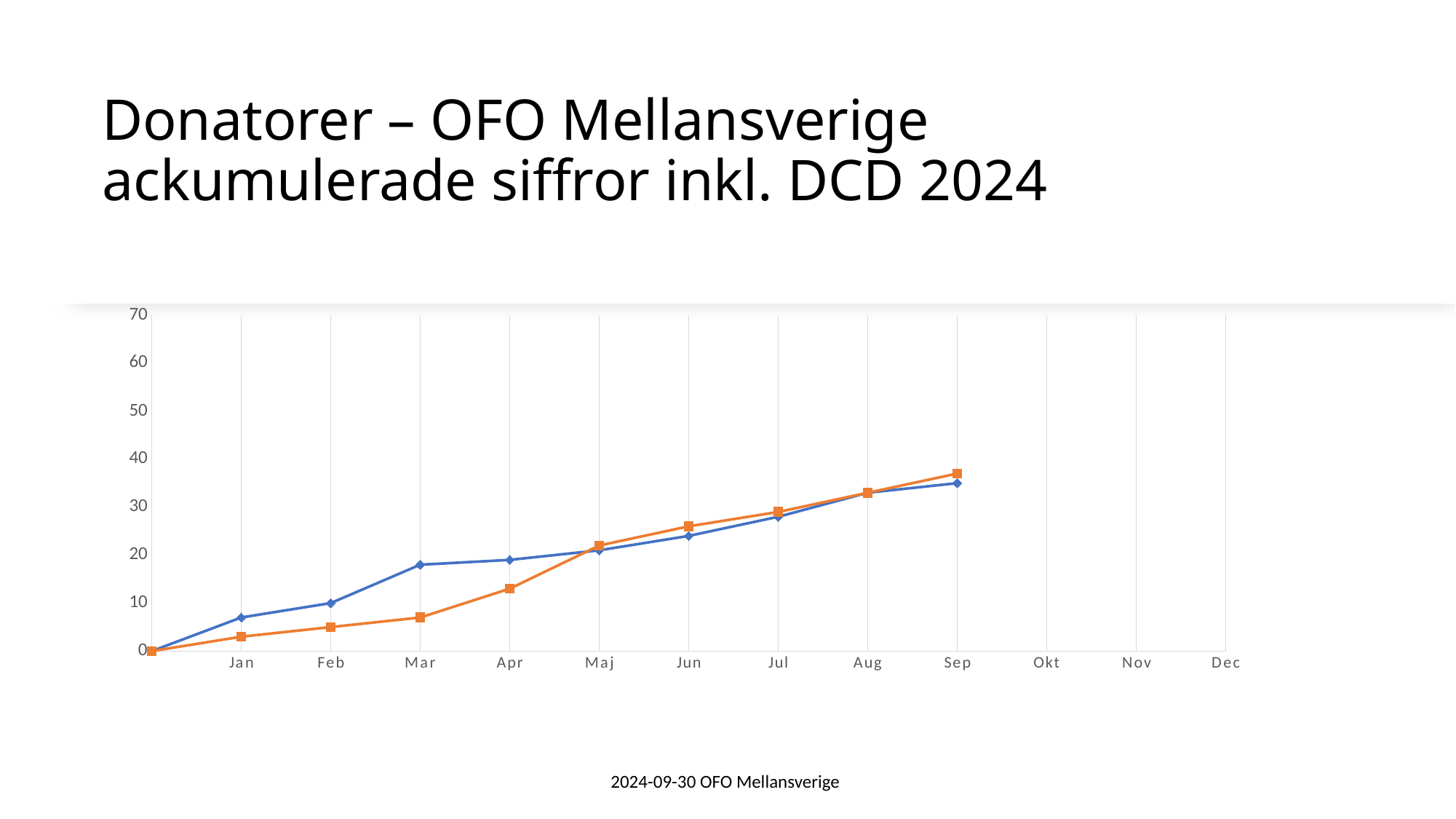
Is the value of the orange line in Jun greater or less than 20? greater Is the value of the blue line in Mar greater or less than 10? greater In Mar, which line has the higher value, the blue line or the orange line? the blue line What is the highest value shown on the y axis? 70 Is the value of the orange line in Jan greater or less than 10? less Do the values of the blue line rise or fall from Jan to Sep? rise What is the last month on the x axis that has plotted data points? Sep In Sep, which line has the higher value, the blue line or the orange line? the orange line What kind of chart is shown on the slide? line chart How many lines (series) are plotted on the chart? 2